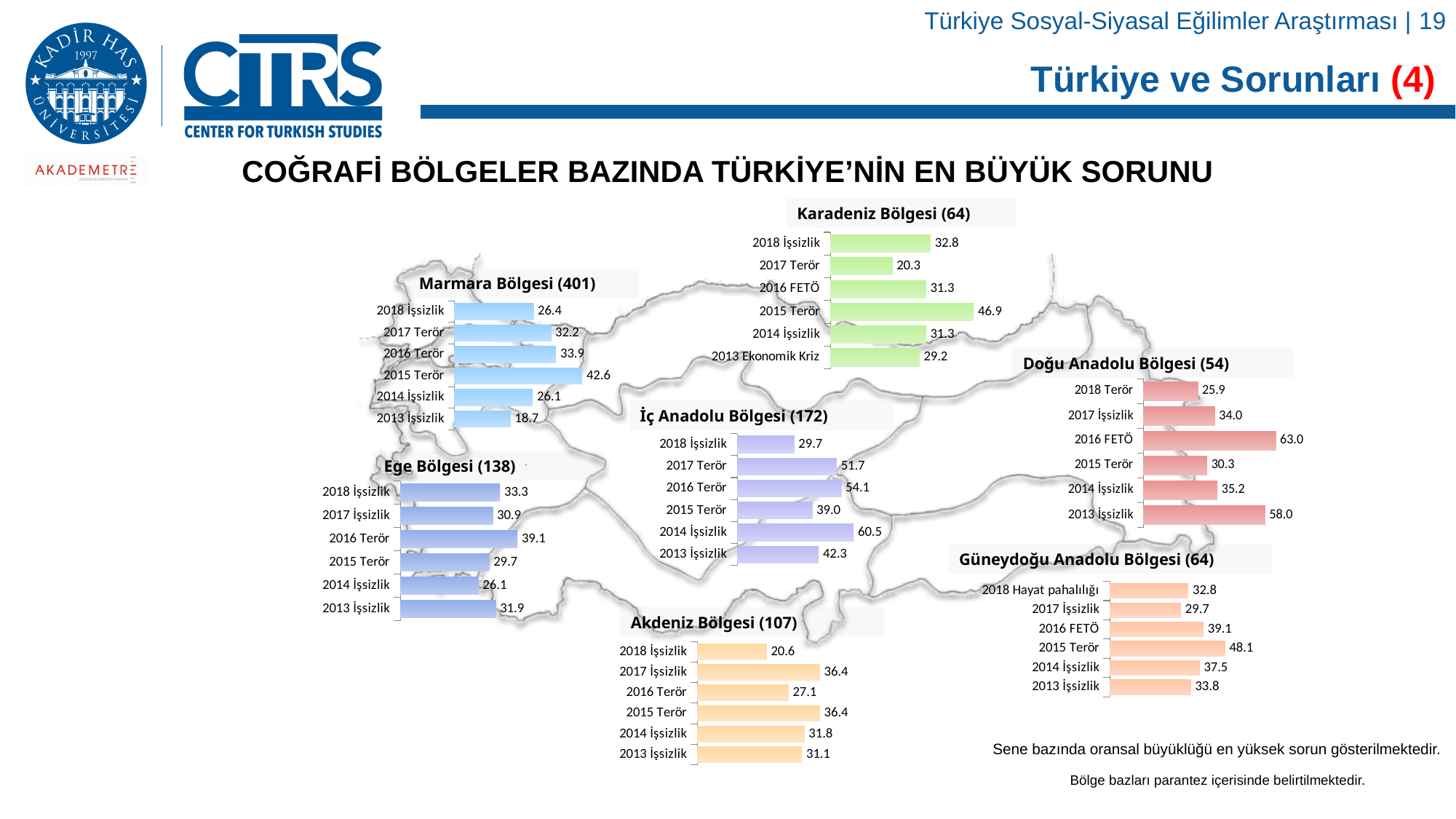
How many bars does the Marmara Bölgesi (401) chart have? 6 In the Doğu Anadolu Bölgesi (54) chart, what is the difference between 2013 İşsizlik and 2018 Terör? 32.1 In the Karadeniz Bölgesi (64) chart, what is the label of the bar for 2013? 2013 Ekonomik Kriz What type of chart is the Karadeniz Bölgesi (64) chart? Bar chart How many regional charts are shown on the slide? 7 In the Doğu Anadolu Bölgesi (54) chart, what is the value for 2016 FETÖ? 63.0 In the Akdeniz Bölgesi (107) chart, which is larger: 2017 İşsizlik or 2016 Terör? 2017 İşsizlik In the Karadeniz Bölgesi (64) chart, which category has the highest value? 2015 Terör In the İç Anadolu Bölgesi (172) chart, which category has the lowest value? 2018 İşsizlik In the Güneydoğu Anadolu Bölgesi (64) chart, what is the value for 2018 Hayat pahalılığı? 32.8 In the Ege Bölgesi (138) chart, what is the difference between 2016 Terör and 2014 İşsizlik? 13.0 In the Marmara Bölgesi (401) chart, what is the value for 2015 Terör? 42.6